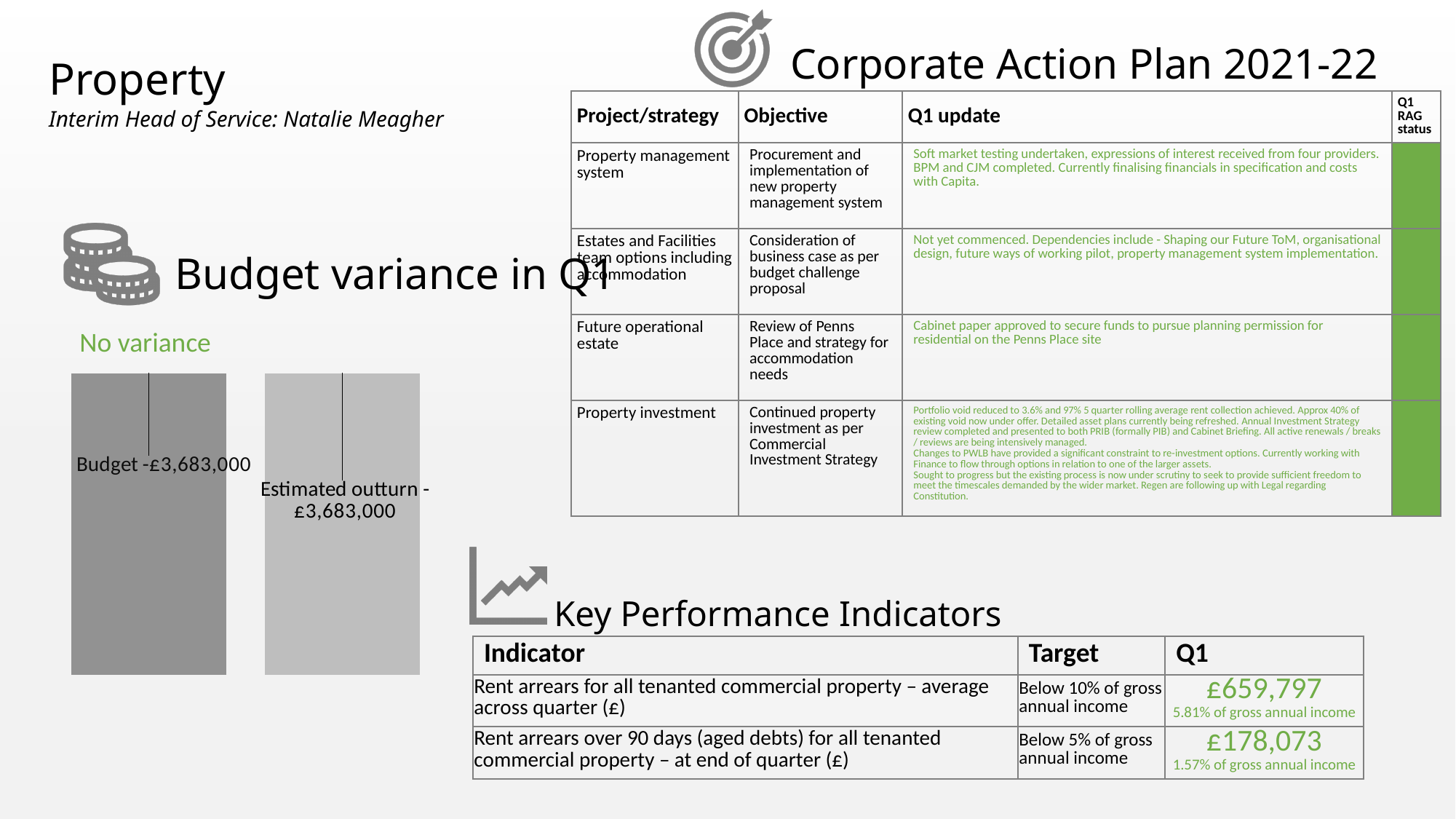
What is the Budget value shown in the 'Budget variance in Q1' chart? £3,683,000 What kind of chart is shown under the heading 'Budget variance in Q1'? bar chart What are the labels of the two bars in the 'Budget variance in Q1' chart? Budget and Estimated outturn What is the difference between the Budget and the Estimated outturn in the 'Budget variance in Q1' chart? £0 How many bars does the 'Budget variance in Q1' chart show? 2 What text in green appears above the 'Budget variance in Q1' chart describing the variance? No variance In the 'Budget variance in Q1' chart, is the Estimated outturn larger than, smaller than, or equal to the Budget? equal What is the Estimated outturn value shown in the 'Budget variance in Q1' chart? £3,683,000